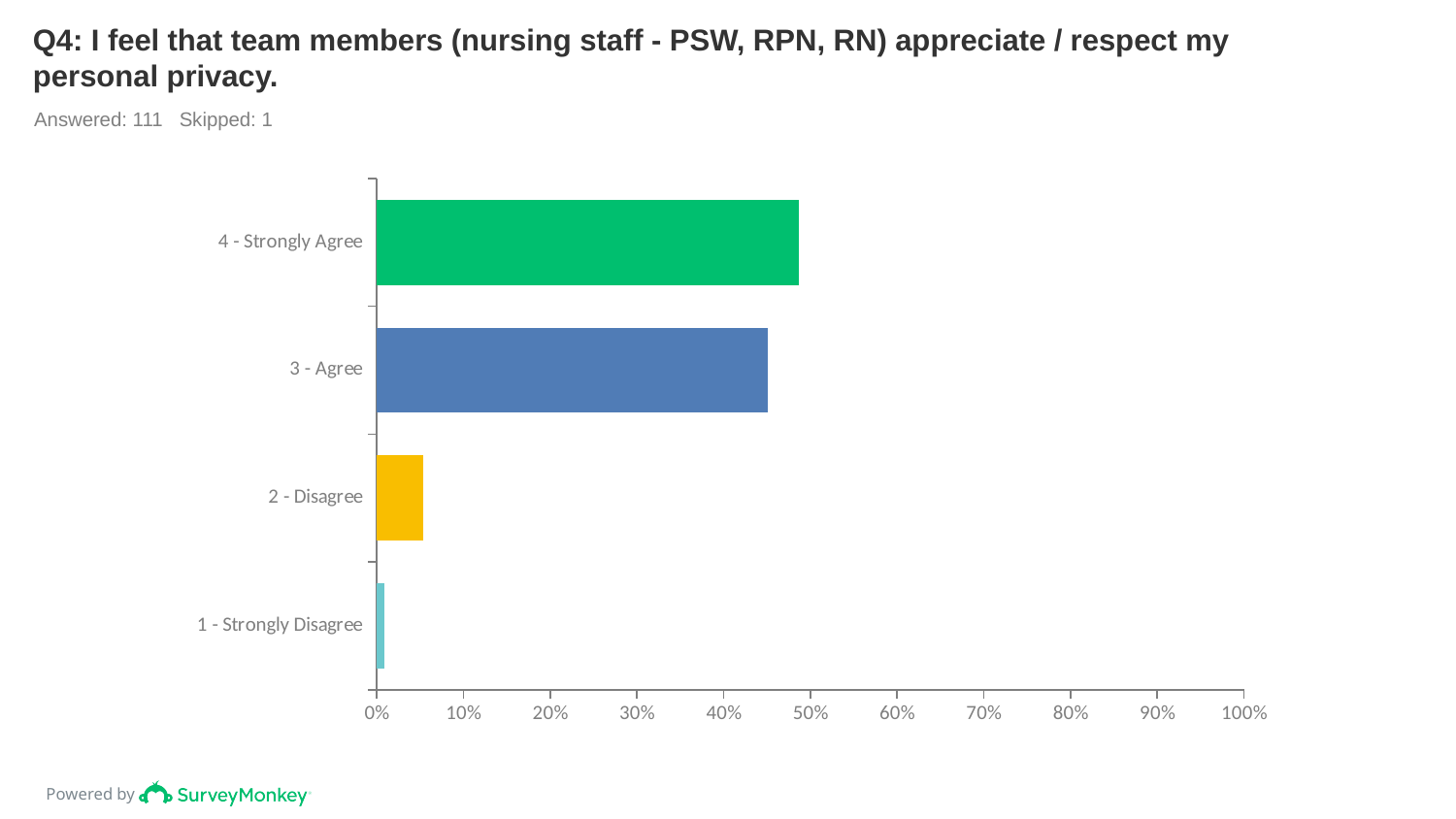
Is the value for 4 - Strongly Agree greater or less than 50%? less Which response category has the longest bar? 4 - Strongly Agree Is the value for 4 - Strongly Agree greater or less than 40%? greater Is the value for 1 - Strongly Disagree greater or less than 10%? less Which response category has the shortest bar? 1 - Strongly Disagree Which is larger, the value for 2 - Disagree or the value for 1 - Strongly Disagree? 2 - Disagree What colour is the bar for 3 - Agree? blue How many respondents answered this question according to the slide? 111 What kind of chart is shown on the slide? bar chart How many response categories are shown on the chart? 4